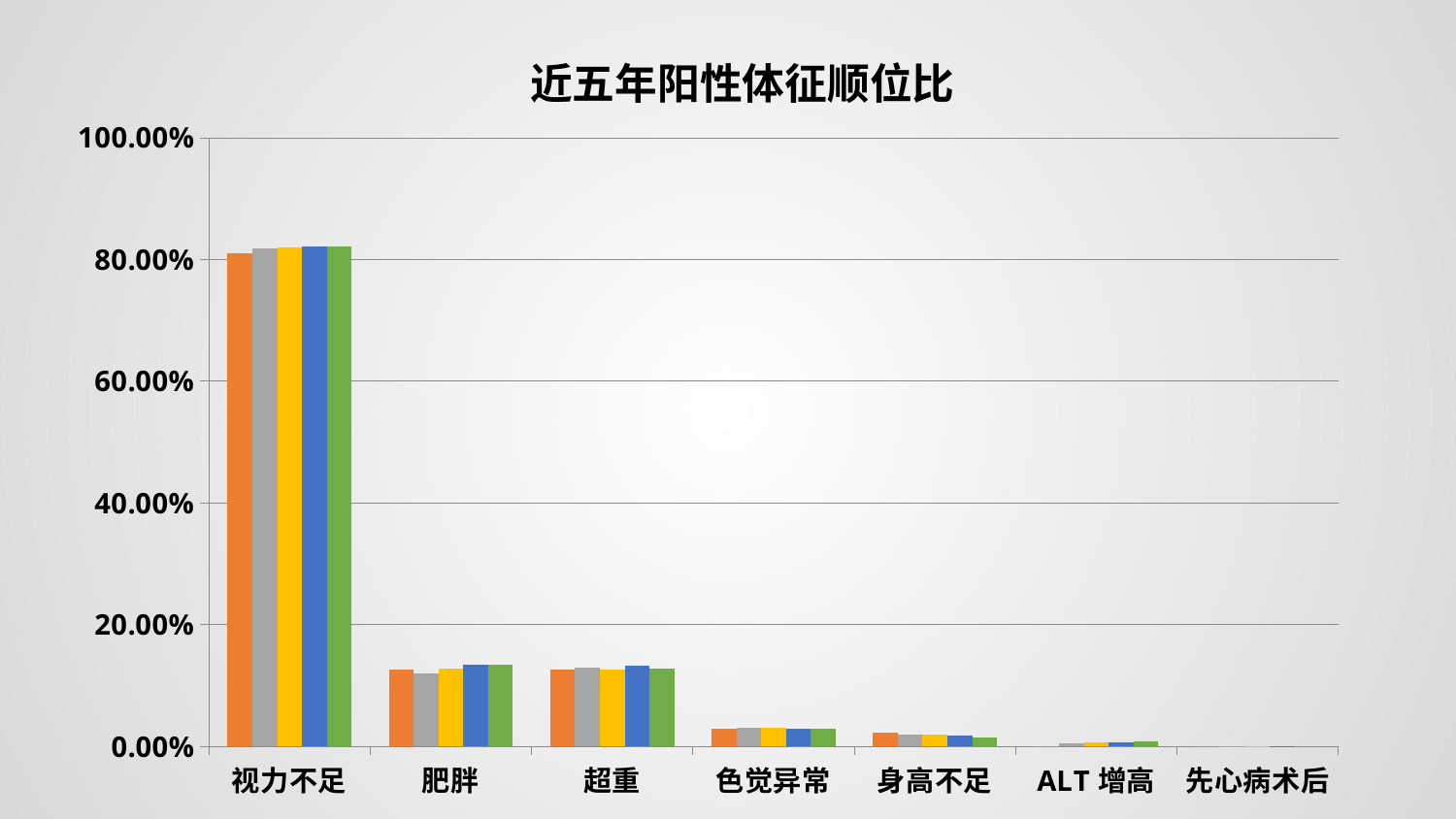
Are the values for 肥胖 greater or less than 20.00%? less Do the values generally rise or fall moving from left to right along the x axis? fall How many categories are shown on the x axis? 7 Which category has larger values, 肥胖 or 身高不足? 肥胖 How many bars are plotted for each category? 5 What is the title of the chart? 近五年阳性体征顺位比 Which category has the lowest values? 先心病术后 Are the values for 色觉异常 greater or less than 20.00%? less Which category has the highest values? 视力不足 Which category has larger values, 视力不足 or 超重? 视力不足 Are the values for 视力不足 greater or less than 60.00%? greater What kind of chart is shown on the slide? bar chart